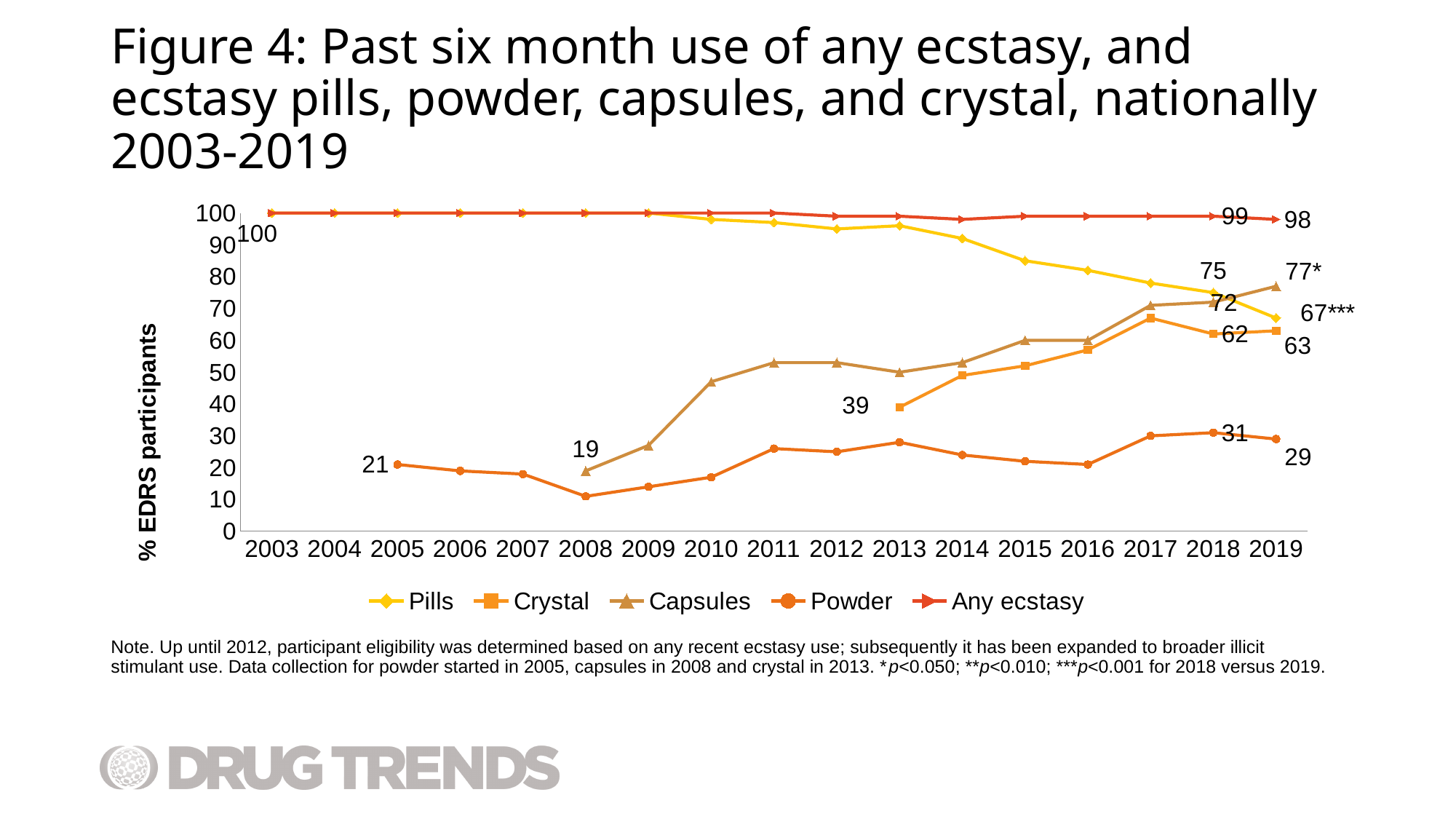
What kind of chart is shown on the slide? line chart What is the value for Any ecstasy in 2019? 98 What is the value for Crystal in 2013? 39 How many years are shown on the x axis? 17 What is the value for Capsules in 2008? 19 Does the Pills series rise or fall from 2003 to 2019? fall By how much did the Pills value fall from 2018 to 2019? 8 What is the value for Powder in 2005? 21 Is the value for Powder in 2013 greater or less than 40? less In 2019, which is larger: Capsules or Pills? Capsules How many series does the legend list? 5 What is the value for Pills in 2018? 75